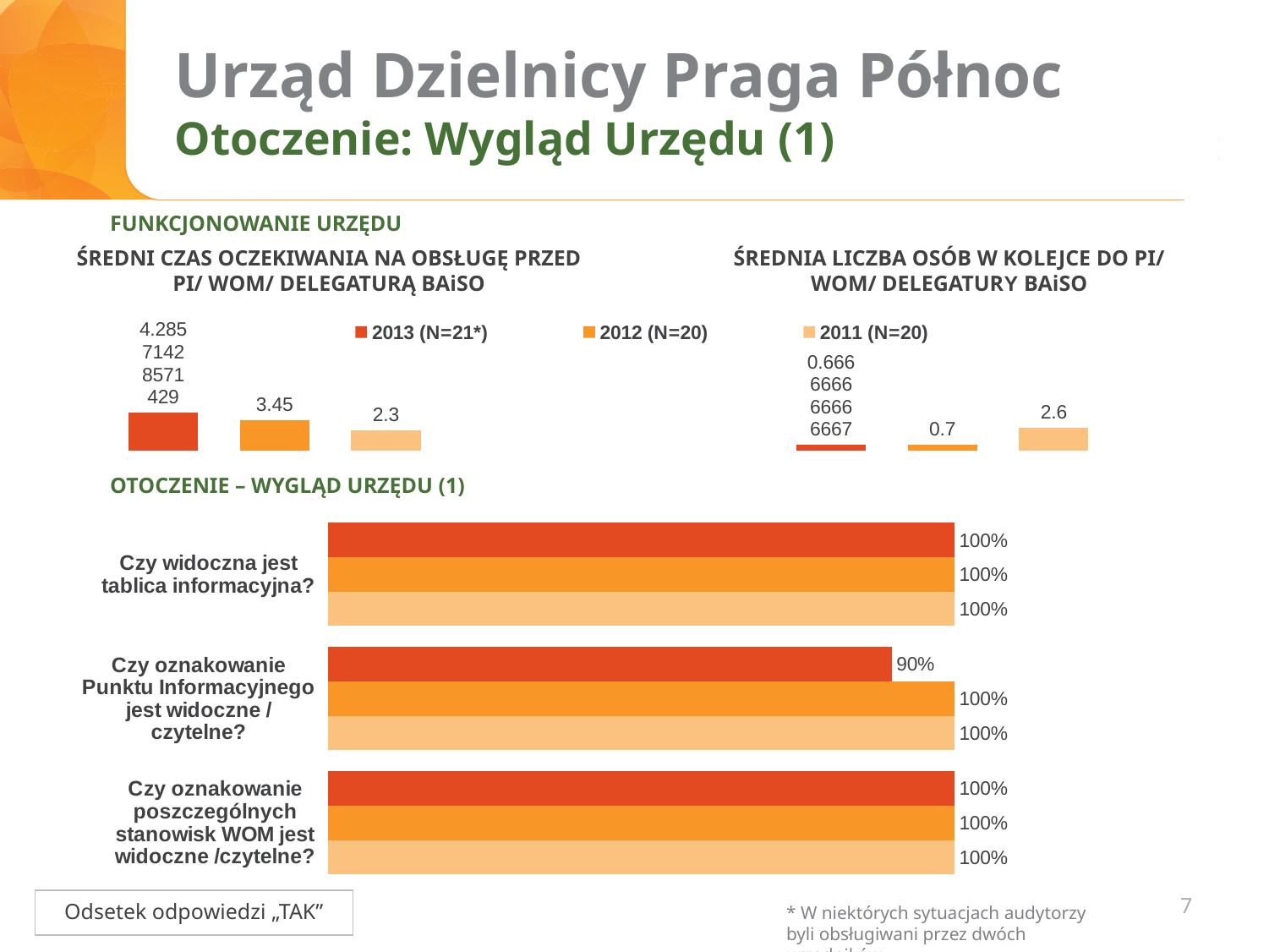
What type of chart is the bottom chart 'Otoczenie – Wygląd Urzędu (1)'? bar chart In the bottom chart 'Otoczenie – Wygląd Urzędu (1)', how many questions (categories) are shown? 3 How many series does the legend for the top charts list? 3 In the chart 'Średnia liczba osób w kolejce do PI/ WOM/ Delegatury BAiSO', which year has the highest value? 2011 (N=20) In the chart 'Średnia liczba osób w kolejce do PI/ WOM/ Delegatury BAiSO', is the value for 2012 larger or smaller than the value for 2011? smaller In the chart 'Średni czas oczekiwania na obsługę przed PI/ WOM/ Delegaturą BAiSO', which year has the highest value? 2013 (N=21*) In the bottom chart 'Otoczenie – Wygląd Urzędu (1)', what is the 2013 value for 'Czy oznakowanie Punktu Informacyjnego jest widoczne / czytelne?'? 90% In the chart 'Średni czas oczekiwania na obsługę przed PI/ WOM/ Delegaturą BAiSO', what is the value for 2011 (N=20)? 2.3 In the chart 'Średnia liczba osób w kolejce do PI/ WOM/ Delegatury BAiSO', what is the value for 2012 (N=20)? 0.7 In the chart 'Średni czas oczekiwania na obsługę przed PI/ WOM/ Delegaturą BAiSO', what is the difference between the 2012 and 2011 values? 1.15 In the chart 'Średnia liczba osób w kolejce do PI/ WOM/ Delegatury BAiSO', what is the value for 2011 (N=20)? 2.6 In the chart 'Średni czas oczekiwania na obsługę przed PI/ WOM/ Delegaturą BAiSO', what is the value for 2012 (N=20)? 3.45